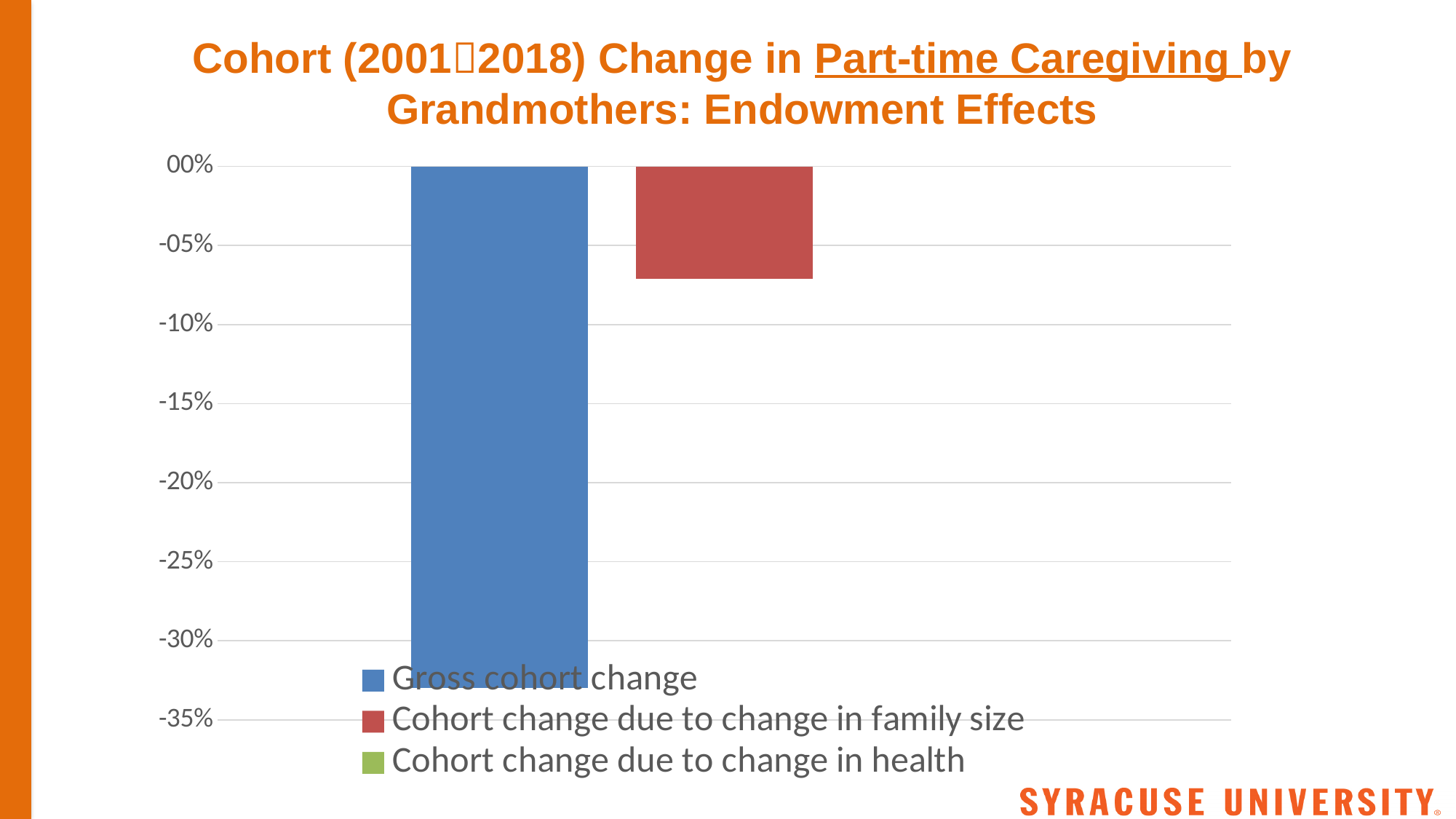
Is the value for Gross cohort change greater or less than -30%? less Which is larger, the value for Gross cohort change or the value for Cohort change due to change in family size? Cohort change due to change in family size Is the value for Cohort change due to change in family size greater or less than -10%? greater Which legend entry is shown in green? Cohort change due to change in health What colour is the bar for Gross cohort change? blue How many series does the legend list? 3 Is the value for Gross cohort change greater or less than -35%? greater What kind of chart is shown on the slide? bar chart Which series has the lowest (most negative) value? Gross cohort change How many bars are visibly plotted on the chart? 2